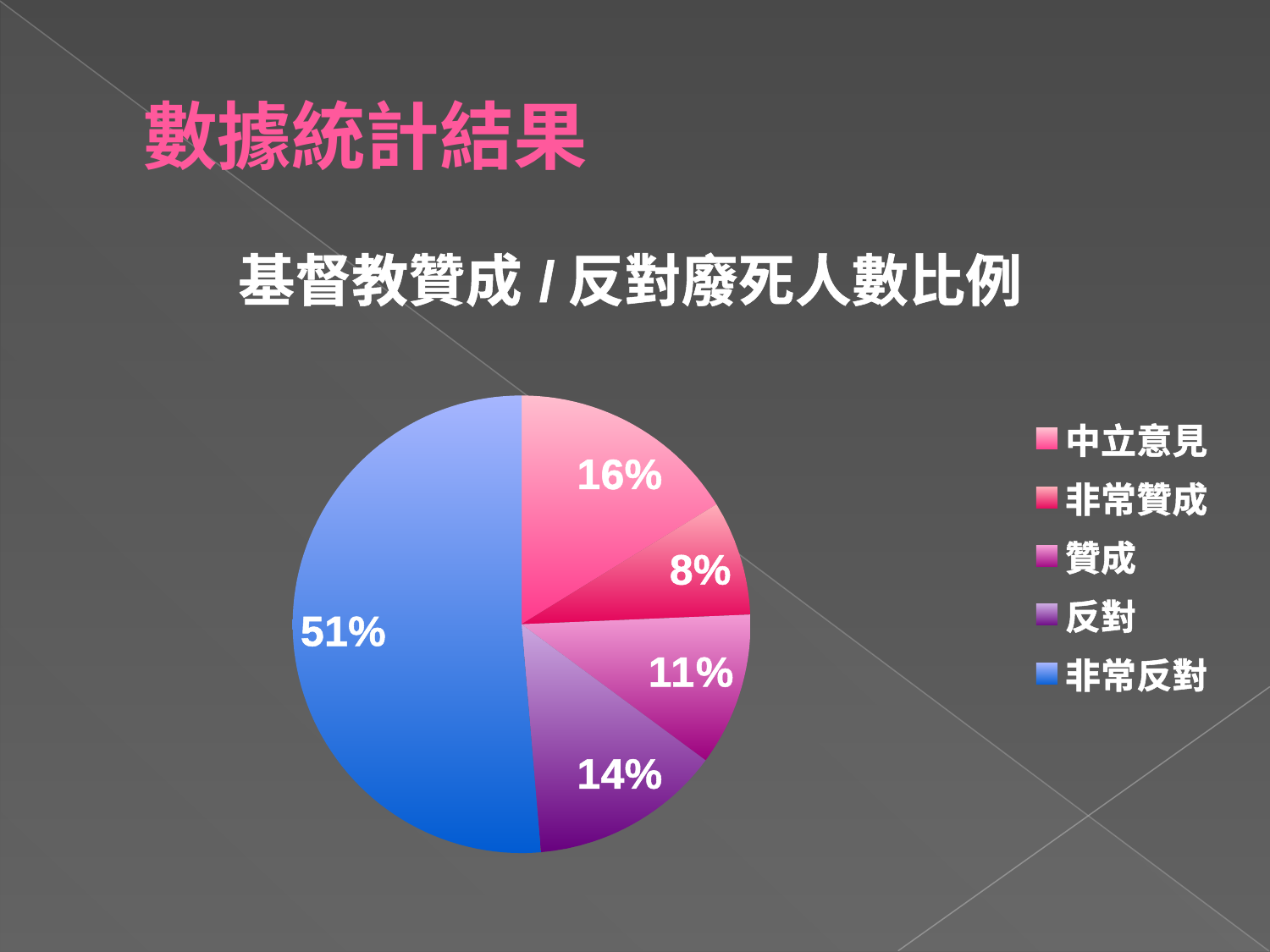
How many categories does the legend list? 5 What is the difference in percentage points between 非常反對 and 中立意見? 35 What percentage of the pie is 非常贊成? 8% What is the title of the chart? 基督教贊成 / 反對廢死人數比例 What percentage of the pie is 反對? 14% What percentage of the pie is 贊成? 11% What percentage of the pie is 非常反對? 51% What kind of chart is shown on the slide? pie chart Which is larger, the share for 反對 or the share for 贊成? 反對 Which category has the smallest share of the pie? 非常贊成 What percentage of the pie is 中立意見? 16% Which category has the largest share of the pie? 非常反對